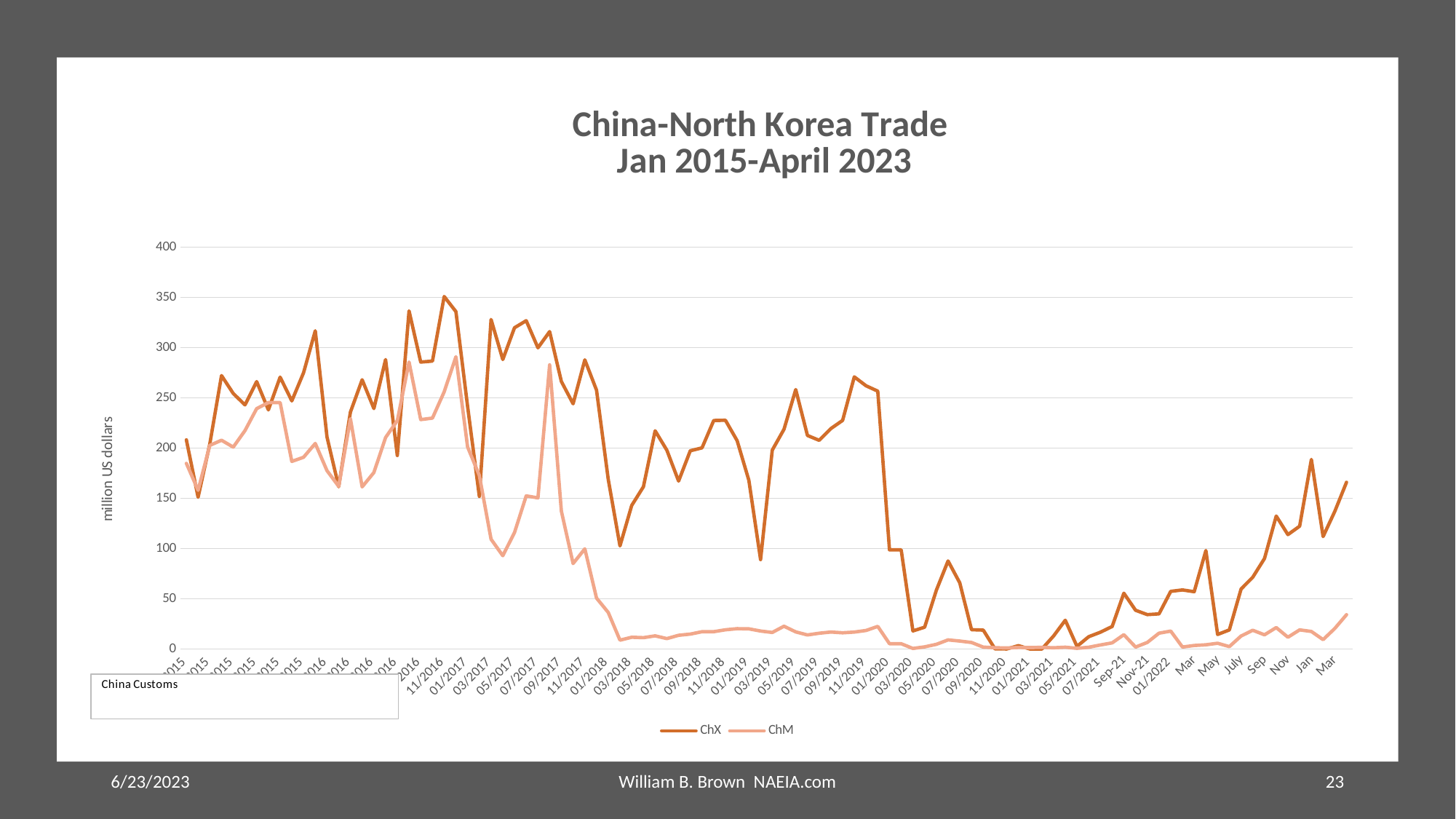
Is the value for ChX at 11/2020 greater or less than 50? less What is the title of the chart? China-North Korea Trade Jan 2015-April 2023 Is the value for ChX at Jan (2023) greater or less than 150? greater Does the ChM series rise or fall between 11/2017 and 03/2018? fall What unit is shown on the vertical axis label? million US dollars How many series does the legend list? 2 What kind of chart is shown on the slide? line chart Which series reaches the higher peak value over the whole period? ChX Is the value for ChM at 03/2018 greater or less than 50? less At 03/2018, which series has the larger value, ChX or ChM? ChX